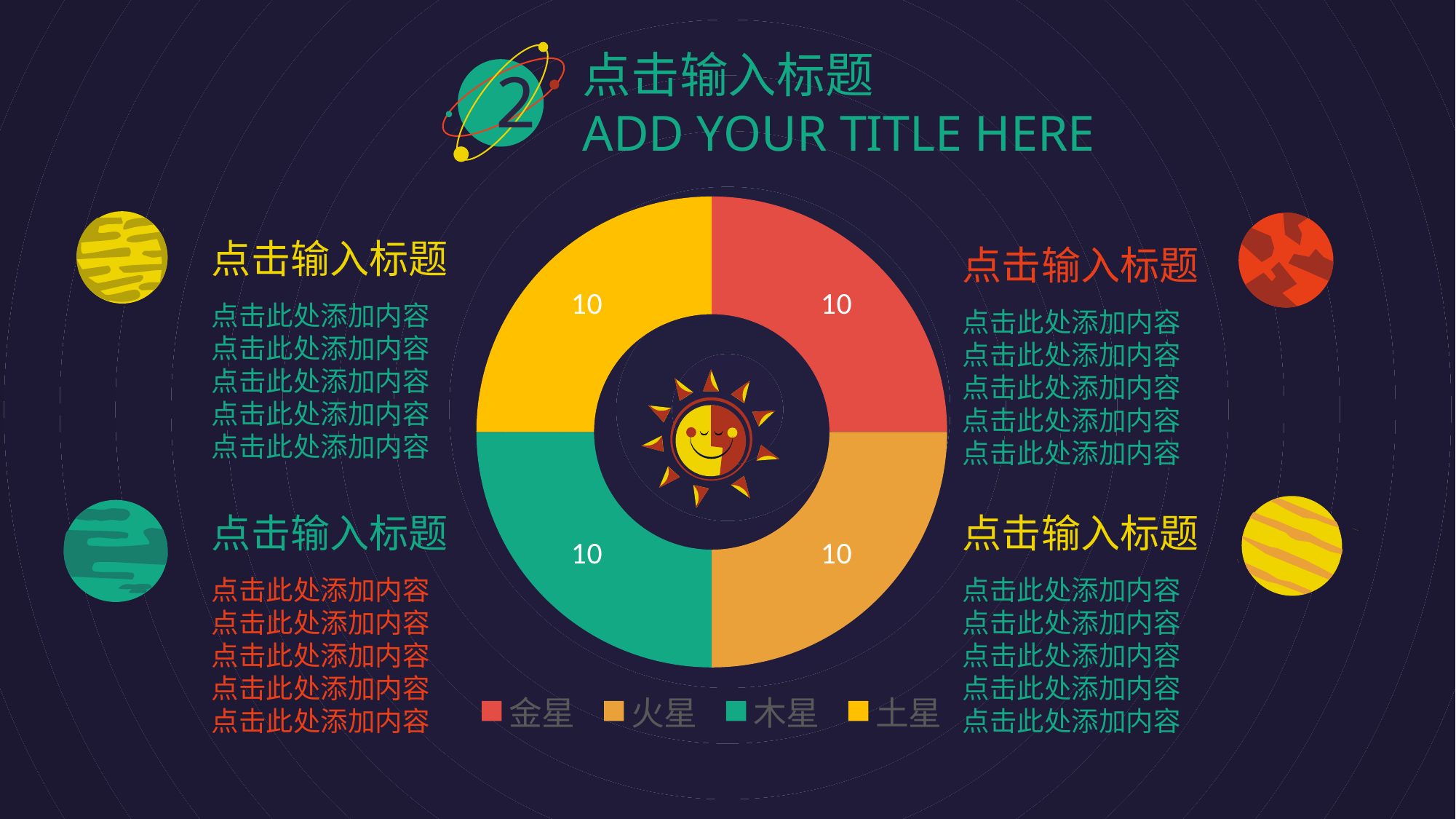
Which legend entry is shown in green? 木星 How many entries does the chart legend list? 4 What is the value for 木星 in the doughnut chart? 10 Which colour represents 火星 in the doughnut chart? Orange What is the difference between the values for 金星 and 土星? 0 What is the value for 火星 in the doughnut chart? 10 What is the value for 土星 in the doughnut chart? 10 What kind of chart is shown on the slide? Doughnut chart What is the total of all four slice values in the doughnut chart? 40 What is the value for 金星 in the doughnut chart? 10 How many slices does the doughnut chart have? 4 What share of the doughnut chart does 木星 represent? 25%